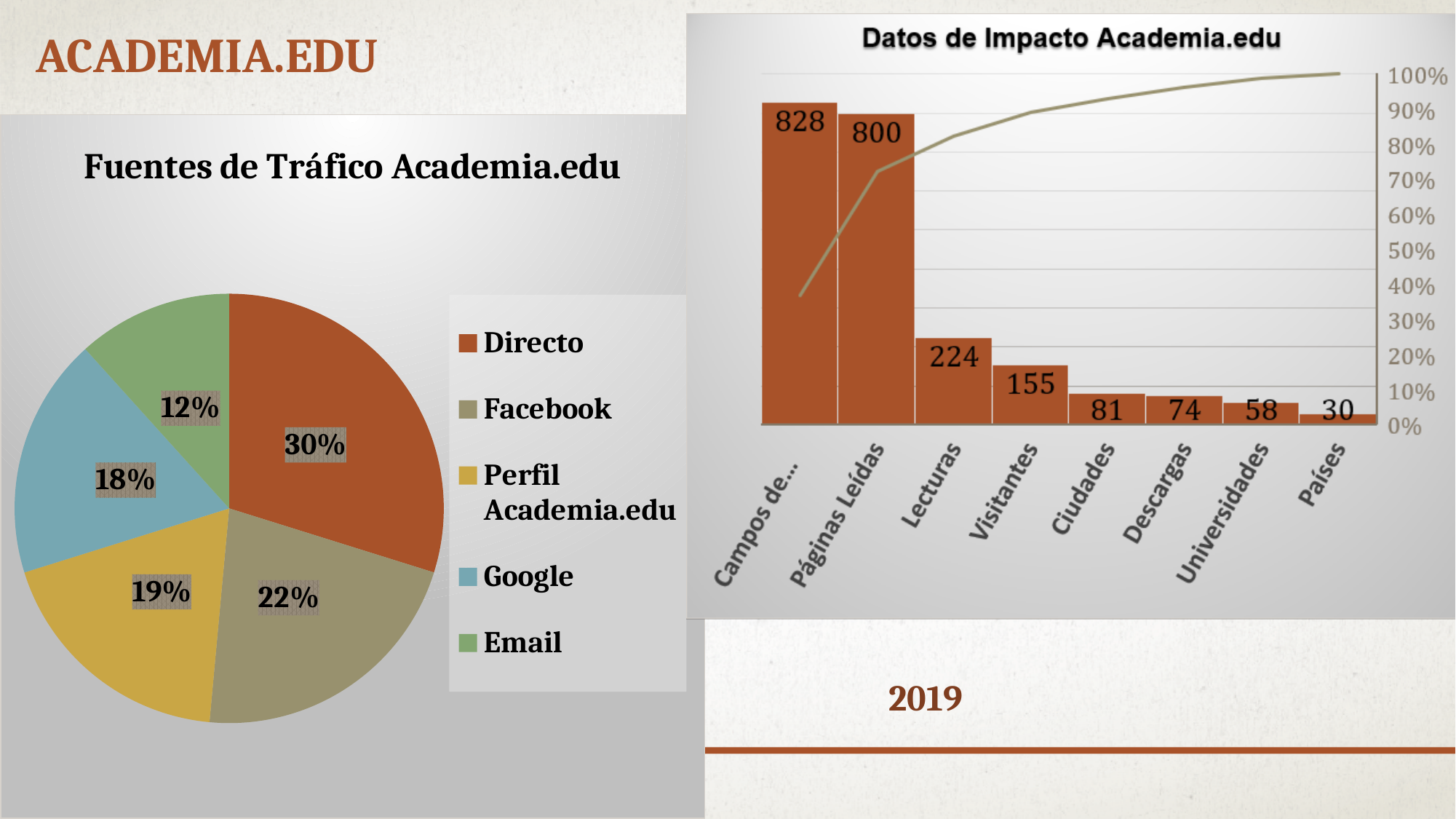
In the 'Datos de Impacto Academia.edu' chart, what is the value for Visitantes? 155 In the 'Datos de Impacto Academia.edu' chart, what is the difference between Lecturas and Ciudades? 143 In the 'Fuentes de Tráfico Academia.edu' pie chart, which source has the smallest share? Email In the 'Datos de Impacto Academia.edu' chart, how many categories are shown on the x axis? 8 In the 'Fuentes de Tráfico Academia.edu' pie chart, what share does Google have? 18% In the 'Fuentes de Tráfico Academia.edu' pie chart, what share does Directo have? 30% In the 'Datos de Impacto Academia.edu' chart, which category has the lowest value? Países In the 'Fuentes de Tráfico Academia.edu' pie chart, which source has the largest share? Directo In the 'Datos de Impacto Academia.edu' chart, what is the value for Páginas Leídas? 800 How many entries does the legend of the 'Fuentes de Tráfico Academia.edu' chart list? 5 In the 'Fuentes de Tráfico Academia.edu' pie chart, how many percentage points larger is Facebook than Perfil Academia.edu? 3% What kind of chart is 'Fuentes de Tráfico Academia.edu'? Pie chart